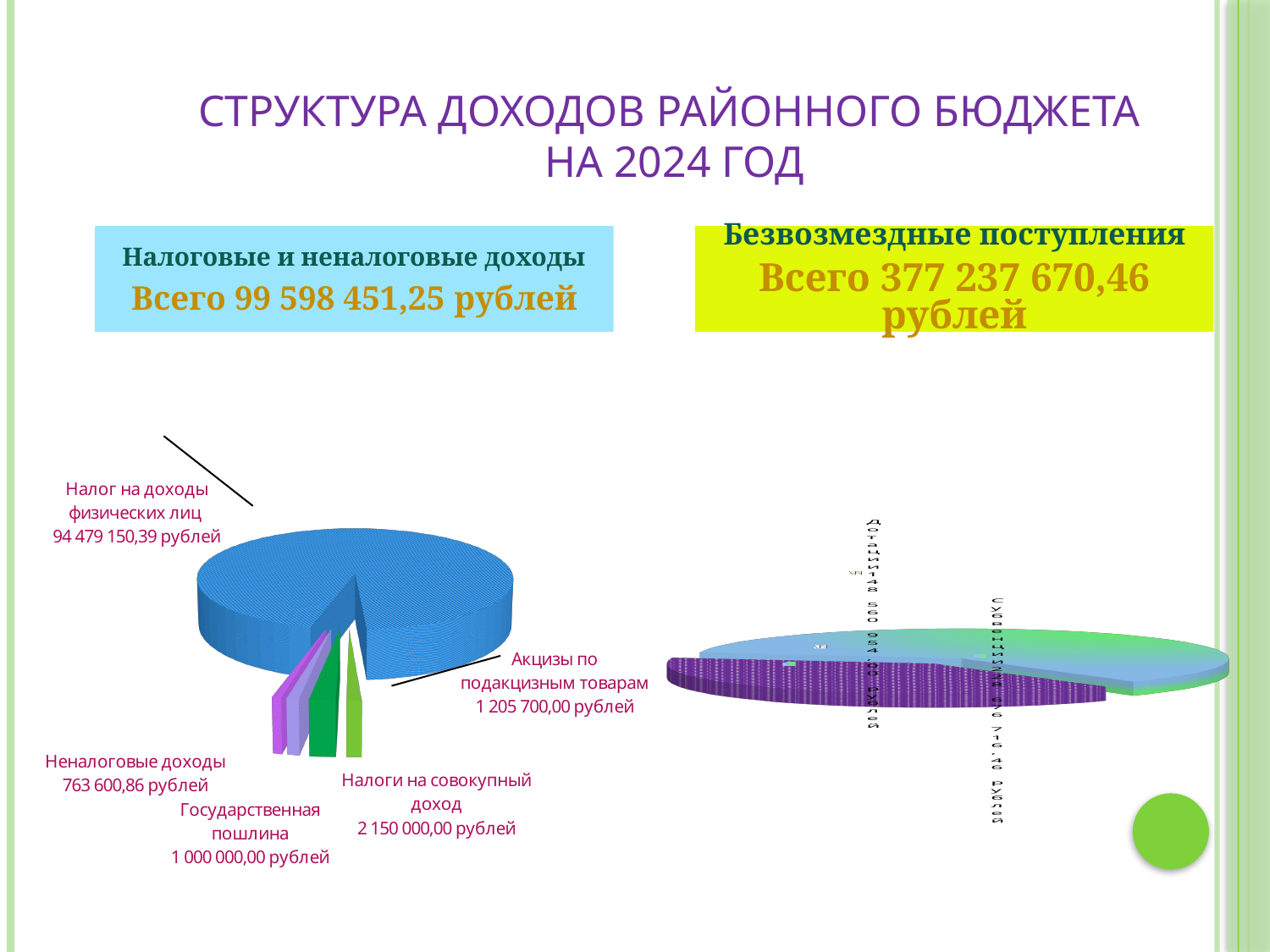
How many categories are shown on the left pie chart (Налоговые и неналоговые доходы)? 5 On the left pie chart, which category has the smallest value? Неналоговые доходы On the left pie chart, what is the value for Акцизы по подакцизным товарам? 1 205 700,00 рублей On the left pie chart, what is the value for Неналоговые доходы? 763 600,86 рублей On the left pie chart, what is the value for Государственная пошлина? 1 000 000,00 рублей On the left pie chart, what is the difference between Государственная пошлина and Неналоговые доходы? 236 399,14 рублей On the left pie chart, which is larger: Акцизы по подакцизным товарам or Государственная пошлина? Акцизы по подакцизным товарам On the left pie chart, what is the difference between Налоги на совокупный доход and Акцизы по подакцизным товарам? 944 300,00 рублей On the left pie chart (Налоговые и неналоговые доходы), what is the value for Налог на доходы физических лиц? 94 479 150,39 рублей What type of chart is used on the left side of the slide for Налоговые и неналоговые доходы? Pie chart On the left pie chart, what is the value for Налоги на совокупный доход? 2 150 000,00 рублей On the left pie chart, which category has the largest value? Налог на доходы физических лиц